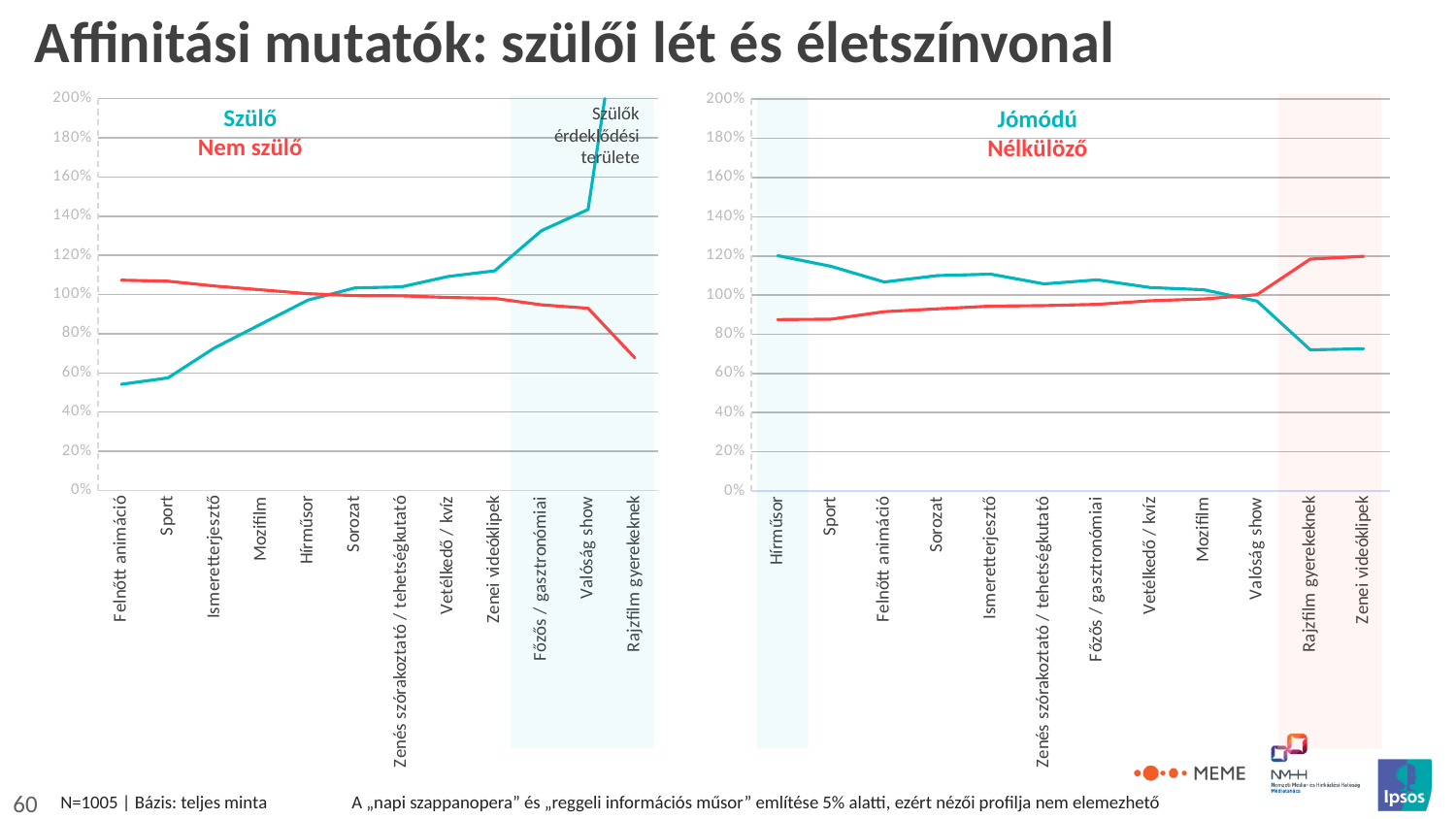
In the right chart, is the Jómódú value for Zenei videóklipek greater or less than 80%? less In the left chart, which series has the larger value for Rajzfilm gyerekeknek, Szülő or Nem szülő? Szülő In the left chart, for which category is the Szülő line lowest? Felnőtt animáció In the left chart, is the Szülő value for Valóság show greater or less than 120%? greater How many series does the left chart (Szülő / Nem szülő) show? 2 In the right chart, is the Nélkülöző value for Hírműsor greater or less than 100%? less How many categories are plotted along the x axis of the right chart (Jómódú / Nélkülöző)? 12 In the right chart, for which category is the Jómódú line highest? Hírműsor In the left chart, does the Szülő line generally rise or fall from left to right along the x axis? rise In the left chart, for which category is the Szülő line highest? Rajzfilm gyerekeknek What kind of chart is the left chart (Szülő / Nem szülő)? line chart